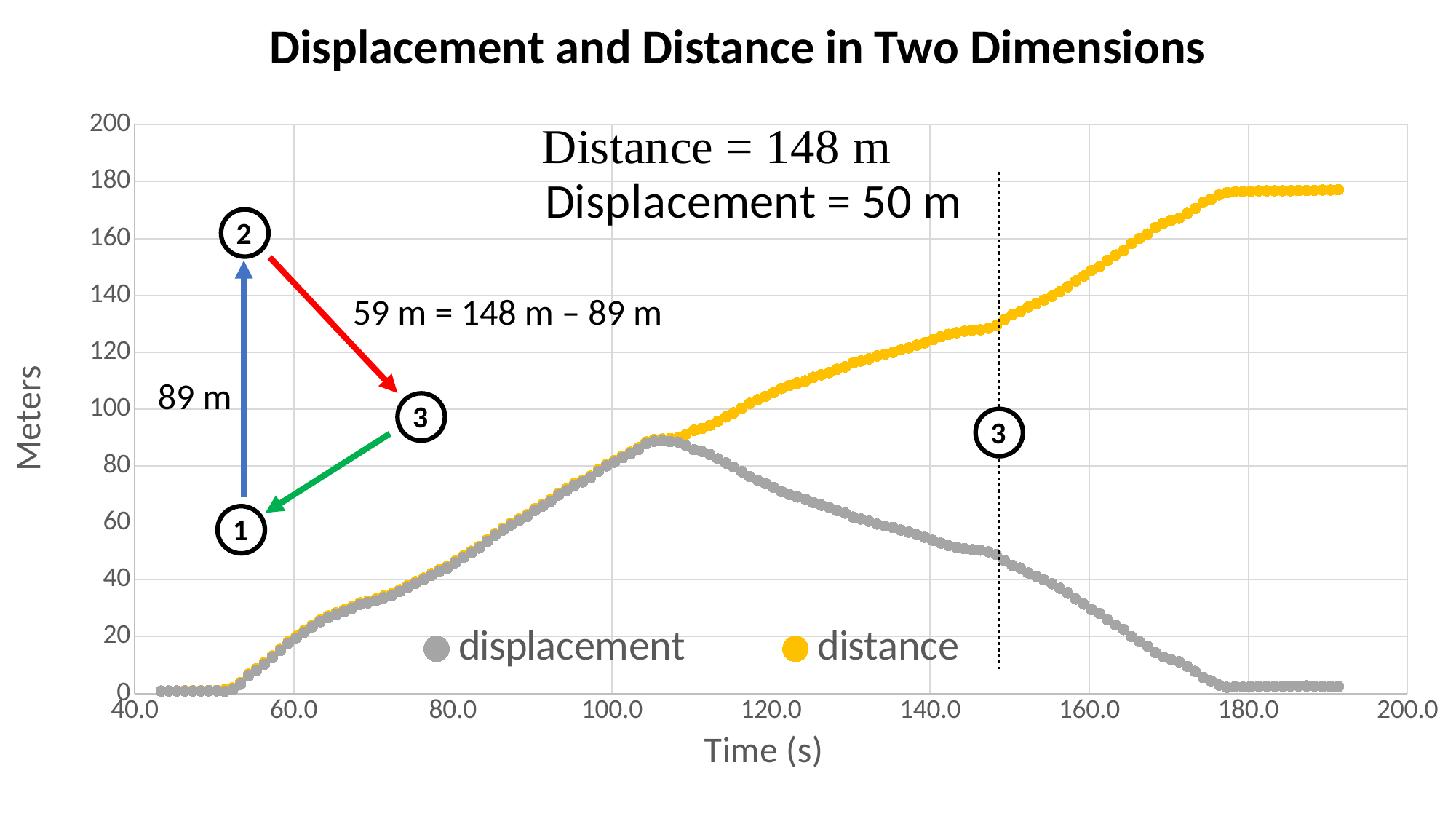
According to the annotation, what is the distance at point 3? 148 m Does the displacement series rise or fall between 120.0 s and 180.0 s? fall What is the title of the chart? Displacement and Distance in Two Dimensions Is the distance value at 180.0 s greater or less than 160? greater Which series is shown in yellow? distance What is the label of the y axis? Meters By how much does the annotated distance at point 3 exceed the annotated displacement at point 3? 98 m At 160.0 s, which series has the higher value, displacement or distance? distance Is the displacement value at 180.0 s greater or less than 20? less According to the annotation, what is the displacement at point 3? 50 m What is the label of the x axis? Time (s) How many series does the legend list? 2